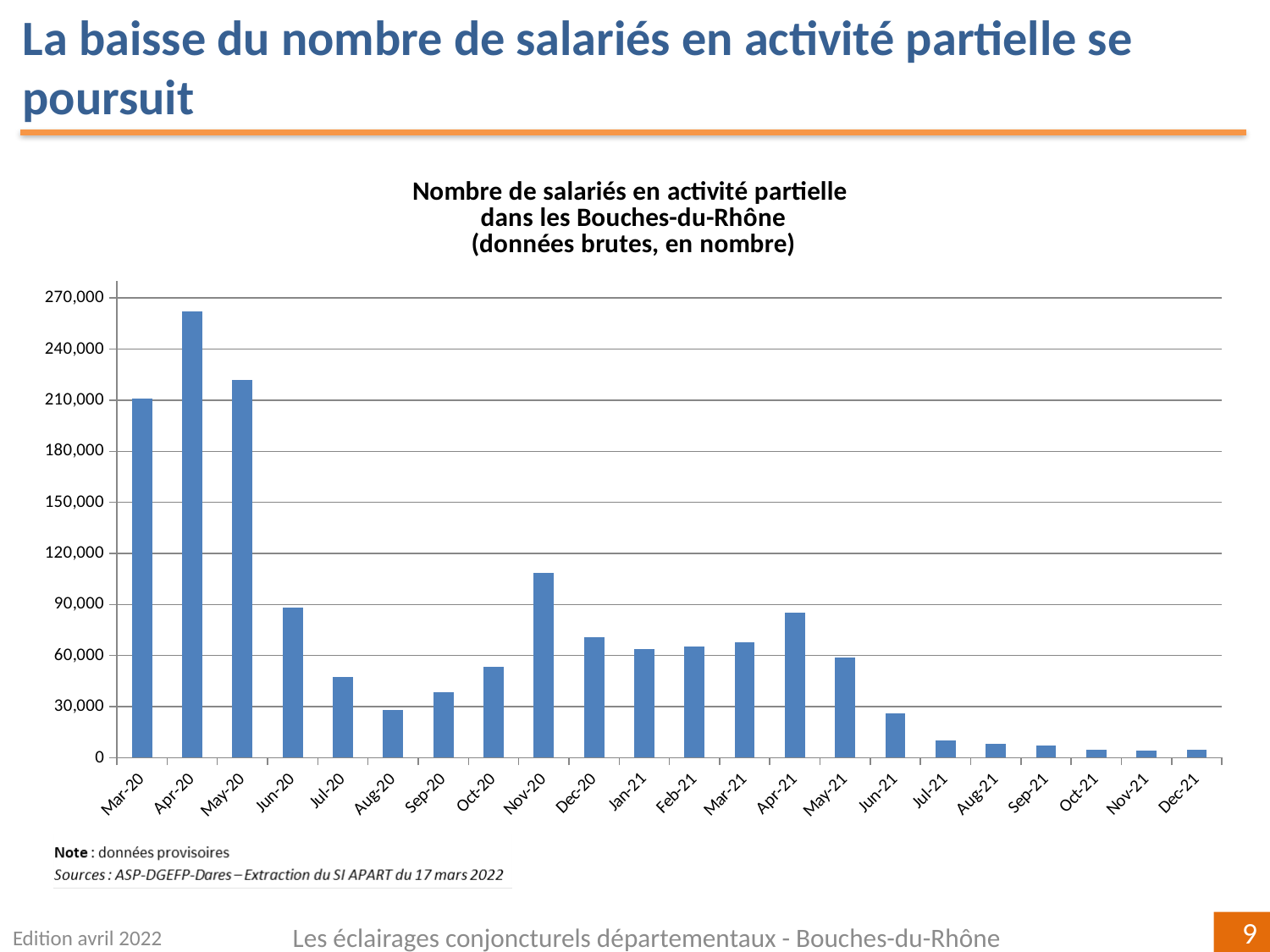
Is the value for Apr-20 greater or less than 240,000? greater Which is larger, the value for Nov-20 or the value for Apr-21? Nov-20 What kind of chart is shown on the slide? bar chart Is the value for Apr-21 greater or less than 60,000? greater Is the value for Jul-21 greater or less than 30,000? less What is the title of the chart? Nombre de salariés en activité partielle dans les Bouches-du-Rhône (données brutes, en nombre) How many months are plotted on the x axis of the chart? 22 Overall, do the values rise or fall from Mar-20 to Dec-21? fall Which month has the highest number of salariés en activité partielle? Apr-20 Which is larger, the value for May-20 or the value for Mar-20? May-20